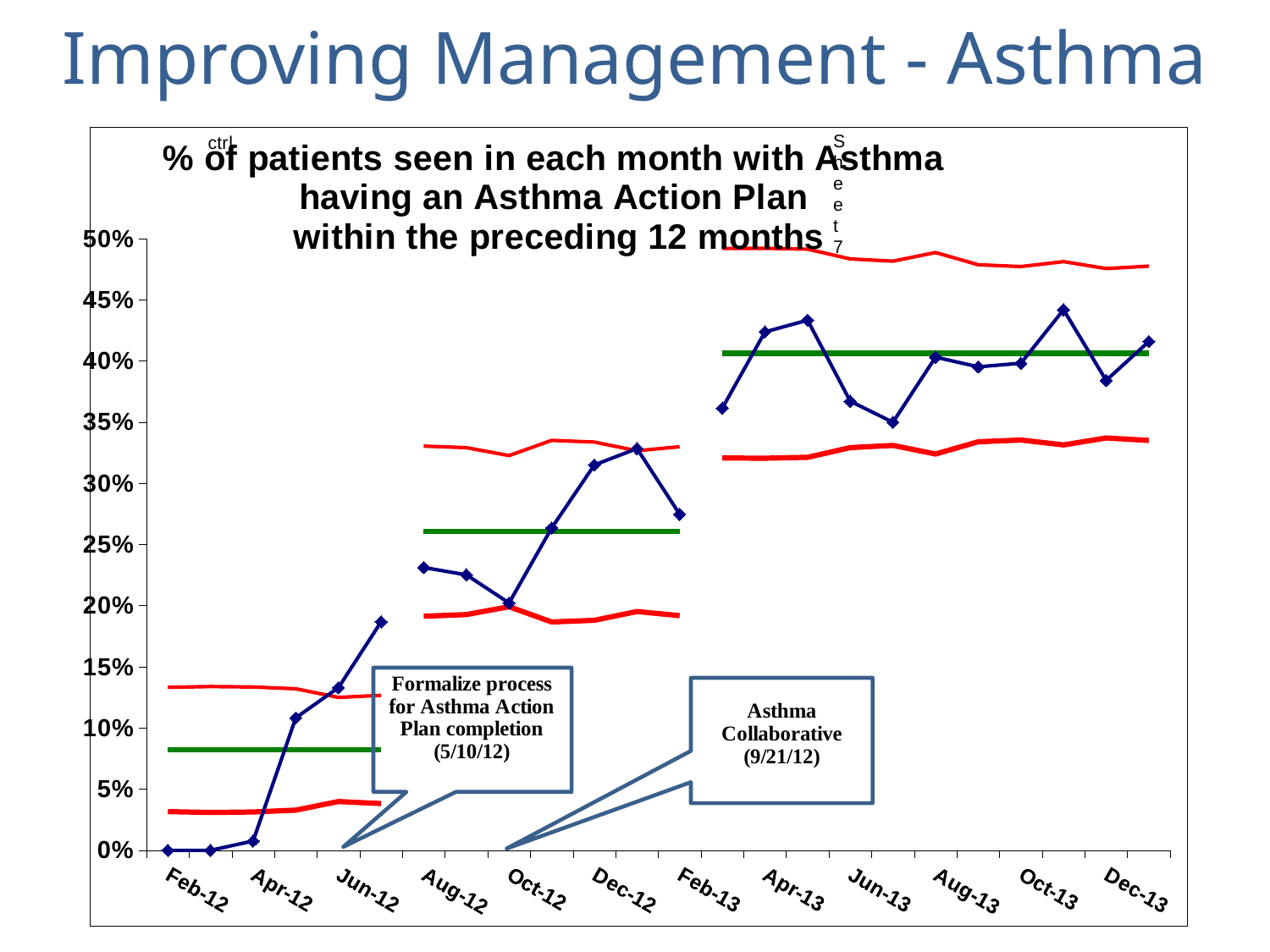
How many month labels are shown on the x axis? 12 Is the value for Apr-13 greater or less than 40%? greater What is the title of the chart? % of patients seen in each month with Asthma having an Asthma Action Plan within the preceding 12 months Which is larger, the value for Jun-12 or the value for Aug-12? Aug-12 What type of chart is shown on the slide? line chart Is the value for Dec-12 greater or less than 30%? greater Do the values generally rise or fall from Feb-12 to Dec-13? rise What event does the annotation dated 9/21/12 refer to? Asthma Collaborative Is the value for Jun-12 greater or less than 20%? less What is the value for Feb-12? 0% Which month has the highest value on the chart? Nov-13